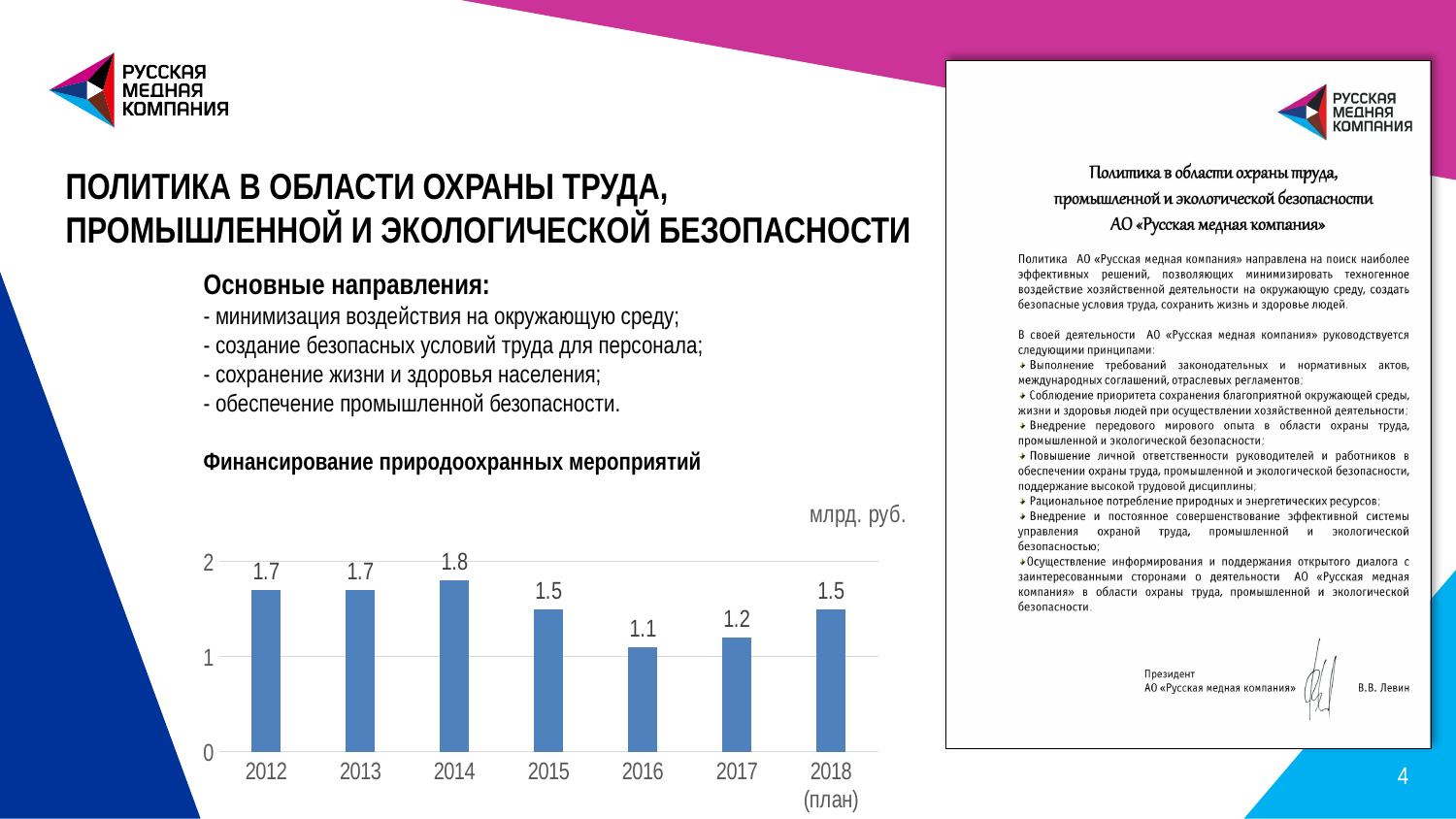
How many years are shown on the x axis of the chart? 7 What is the value for 2016 in the chart? 1.1 What kind of chart is shown on the slide? bar chart Which year has the highest value in the chart? 2014 Which is larger, the value for 2017 or the value for 2018 (план)? 2018 (план) What is the planned value for 2018 (план) in the chart? 1.5 What is the value for 2014 in the chart? 1.8 Is the value for 2013 greater or less than 1? greater What is the difference between the values for 2012 and 2015? 0.2 What unit is indicated for the values in the chart? млрд. руб. Which year has the lowest value in the chart? 2016 What is the difference between the values for 2014 and 2016? 0.7